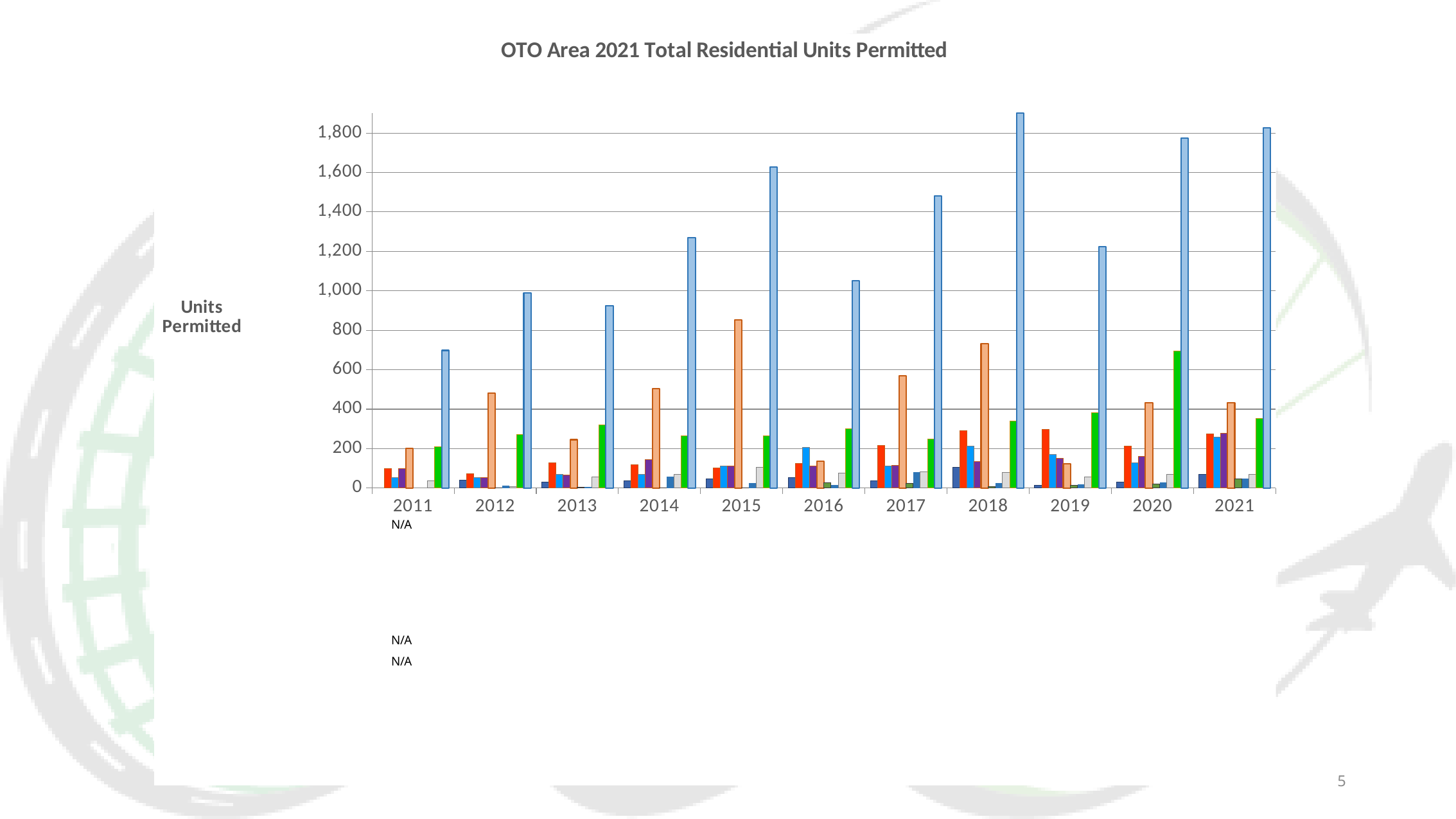
What is the title of the chart? OTO Area 2021 Total Residential Units Permitted Which year has the taller light blue bar, 2020 or 2019? 2020 What is the label on the vertical axis of the chart? Units Permitted Is the tallest bar for 2015 greater or less than 1,600? greater Is the tallest bar for 2011 greater or less than 800? less In which year is the tallest (light blue) bar the lowest? 2011 How many years are shown along the x axis of the chart? 11 Which year has the taller light blue bar, 2015 or 2016? 2015 In which year does the tallest bar in the chart reach its highest value? 2018 What kind of chart is shown on the slide? bar chart Is the tallest bar for 2018 greater or less than 1,800? greater